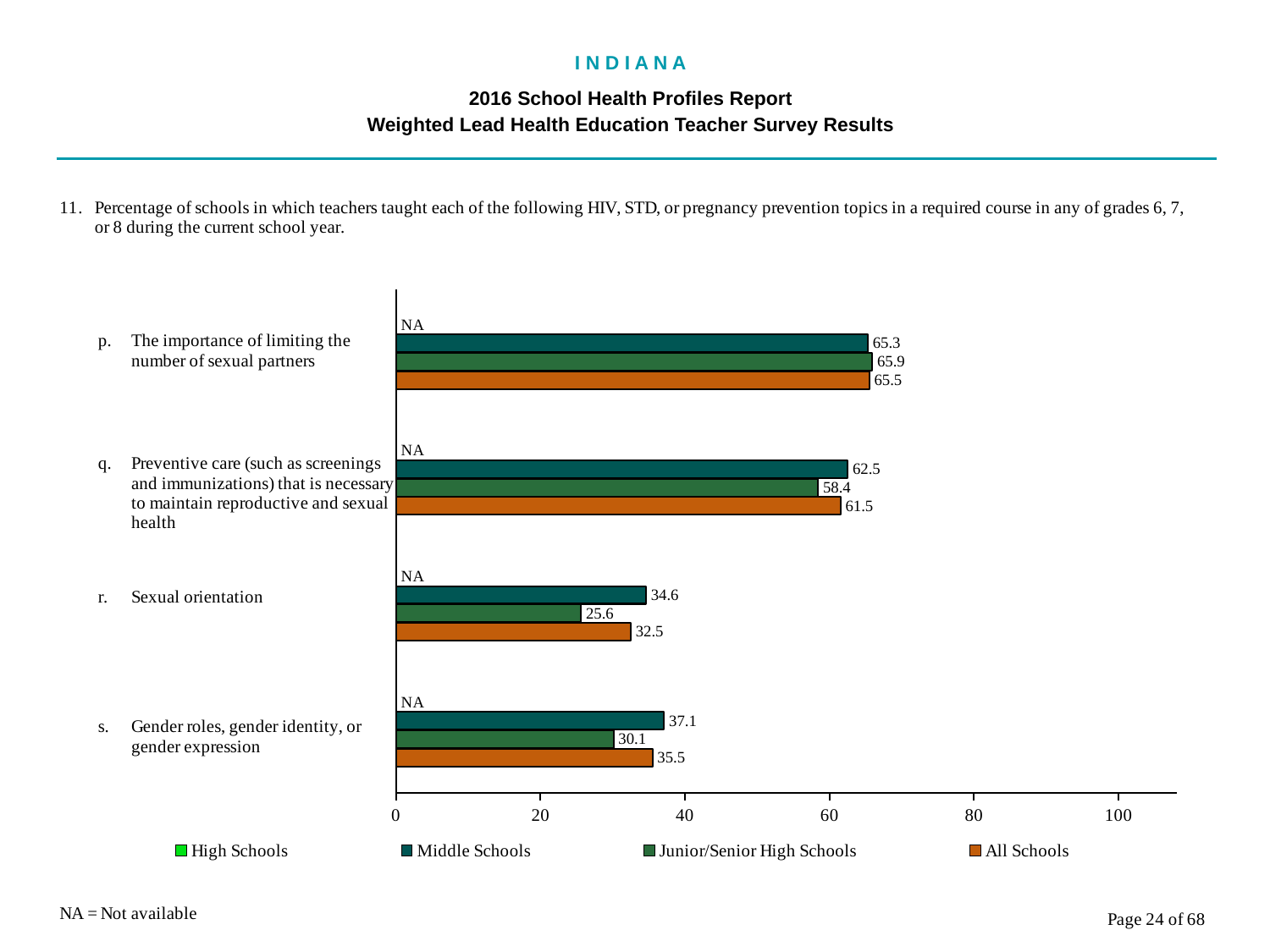
What is the value for Junior/Senior High Schools for 'Sexual orientation'? 25.6 Which topic has the highest All Schools value? The importance of limiting the number of sexual partners How many series does the legend list? 4 For 'Preventive care (such as screenings and immunizations) that is necessary to maintain reproductive and sexual health', which is larger: Middle Schools or Junior/Senior High Schools? Middle Schools What is the value for All Schools for 'Gender roles, gender identity, or gender expression'? 35.5 What does NA stand for according to the note on the slide? Not available What is the difference between the Middle Schools and Junior/Senior High Schools values for 'Sexual orientation'? 9.0 What is shown for High Schools for 'Preventive care (such as screenings and immunizations) that is necessary to maintain reproductive and sexual health'? NA Which topic has the lowest Junior/Senior High Schools value? Sexual orientation How many topics (categories) are plotted on the chart? 4 What is the value for Middle Schools for 'The importance of limiting the number of sexual partners'? 65.3 What kind of chart is shown on the slide? Bar chart